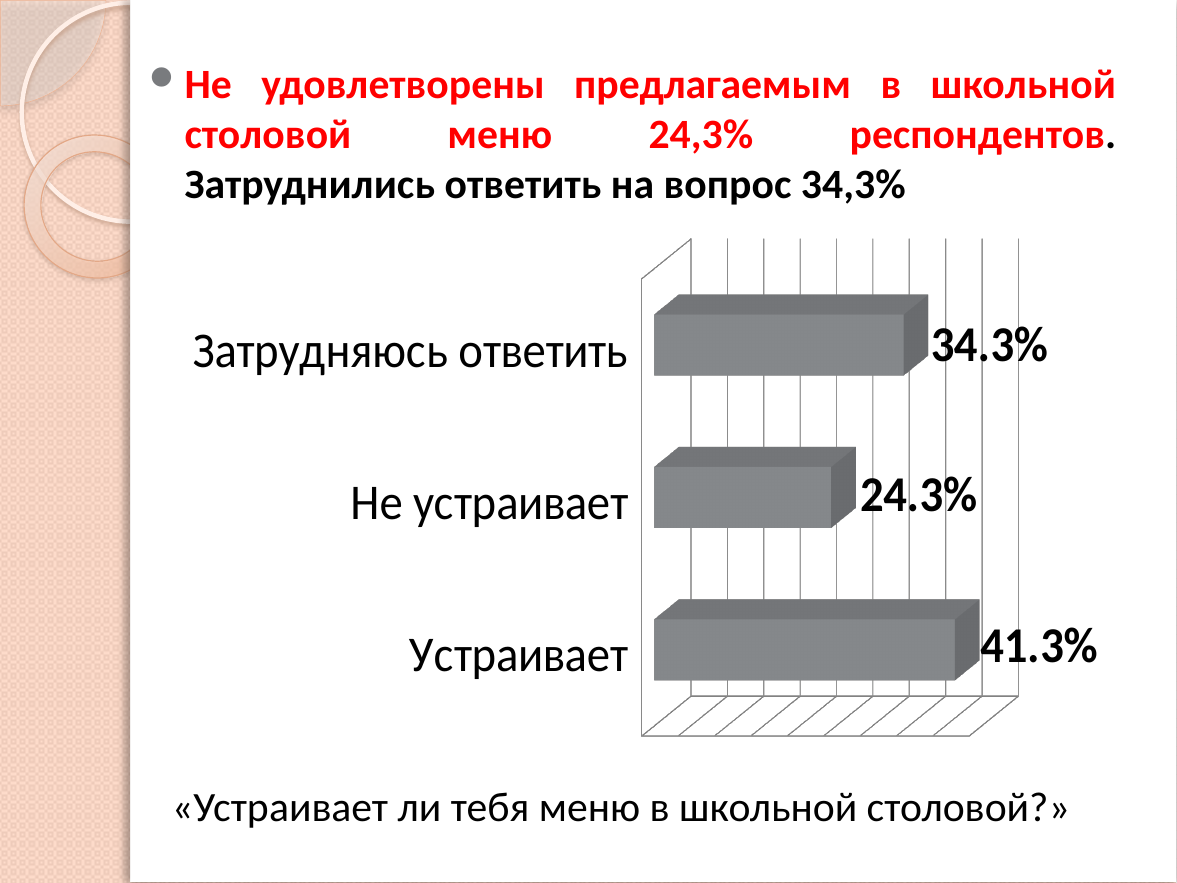
How many categories are shown in the chart? 3 What kind of chart is shown on the slide? Bar chart What value is shown for «Устраивает»? 41.3% What value is shown for «Не устраивает»? 24.3% Which is larger, the value for «Устраивает» or the value for «Затрудняюсь ответить»? Устраивает What is the difference between the values for «Затрудняюсь ответить» and «Не устраивает»? 10.0% Which category has the lowest value? Не устраивает What is the difference between the values for «Устраивает» and «Не устраивает»? 17.0% What question is written below the chart? «Устраивает ли тебя меню в школьной столовой?» Which category has the highest value? Устраивает What value is shown for «Затрудняюсь ответить»? 34.3% Which is larger, the value for «Затрудняюсь ответить» or the value for «Не устраивает»? Затрудняюсь ответить